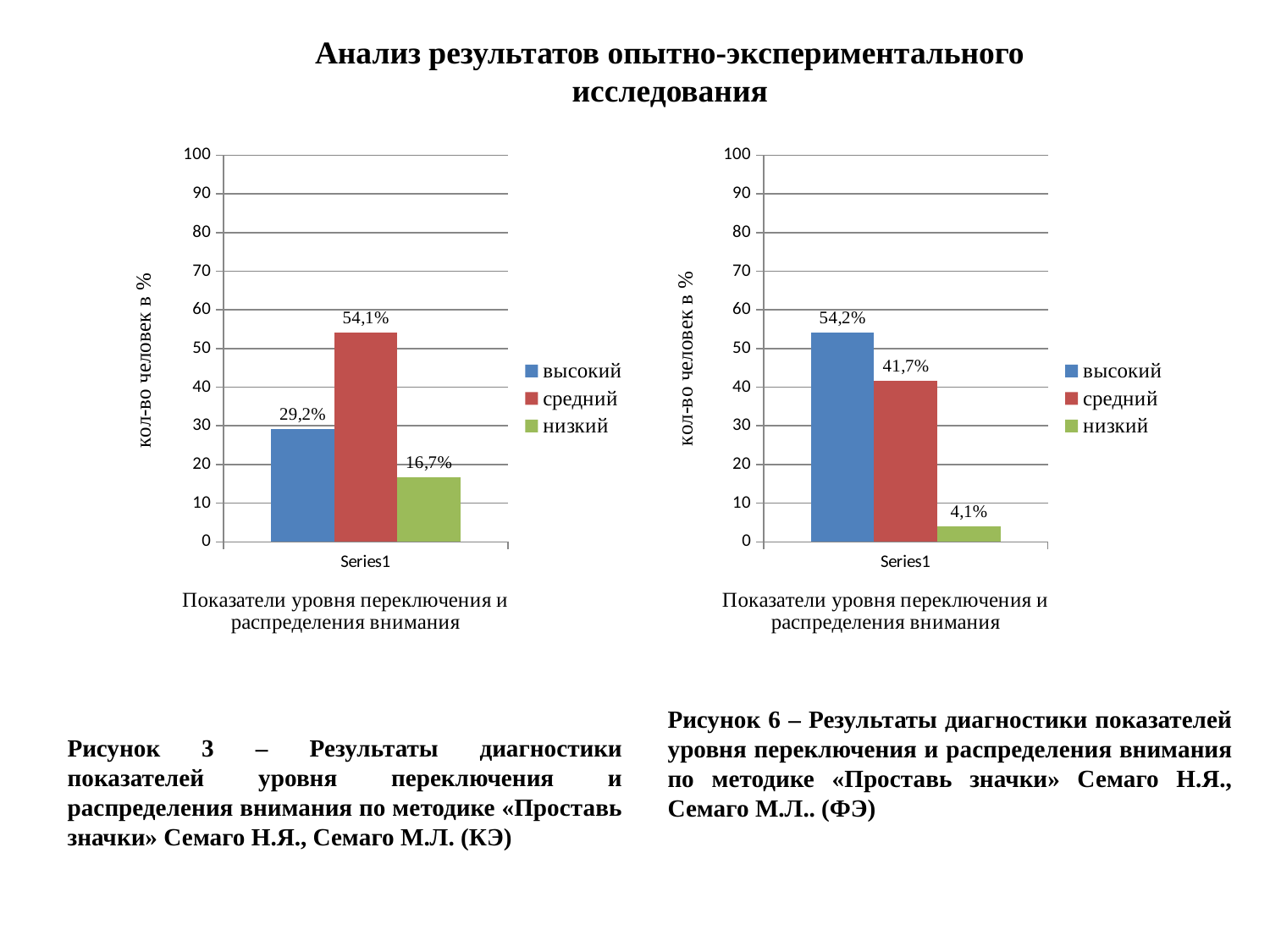
What is the y-axis label of the right chart? кол-во человек в % In the right chart, which is larger, высокий or средний? высокий In the left chart, what is the difference between средний and высокий? 24,9% In the right chart, what is the value for низкий? 4,1% How many series does the legend of the right chart list? 3 What kind of chart is the left chart? bar chart In the right chart, which series has the highest value? высокий In the left chart, what is the value for средний? 54,1% In the left chart, what is the value for высокий? 29,2% In the right chart, what is the difference between высокий and низкий? 50,1% In the left chart, is the value for низкий greater or less than 20? less In the left chart, which series has the lowest value? низкий